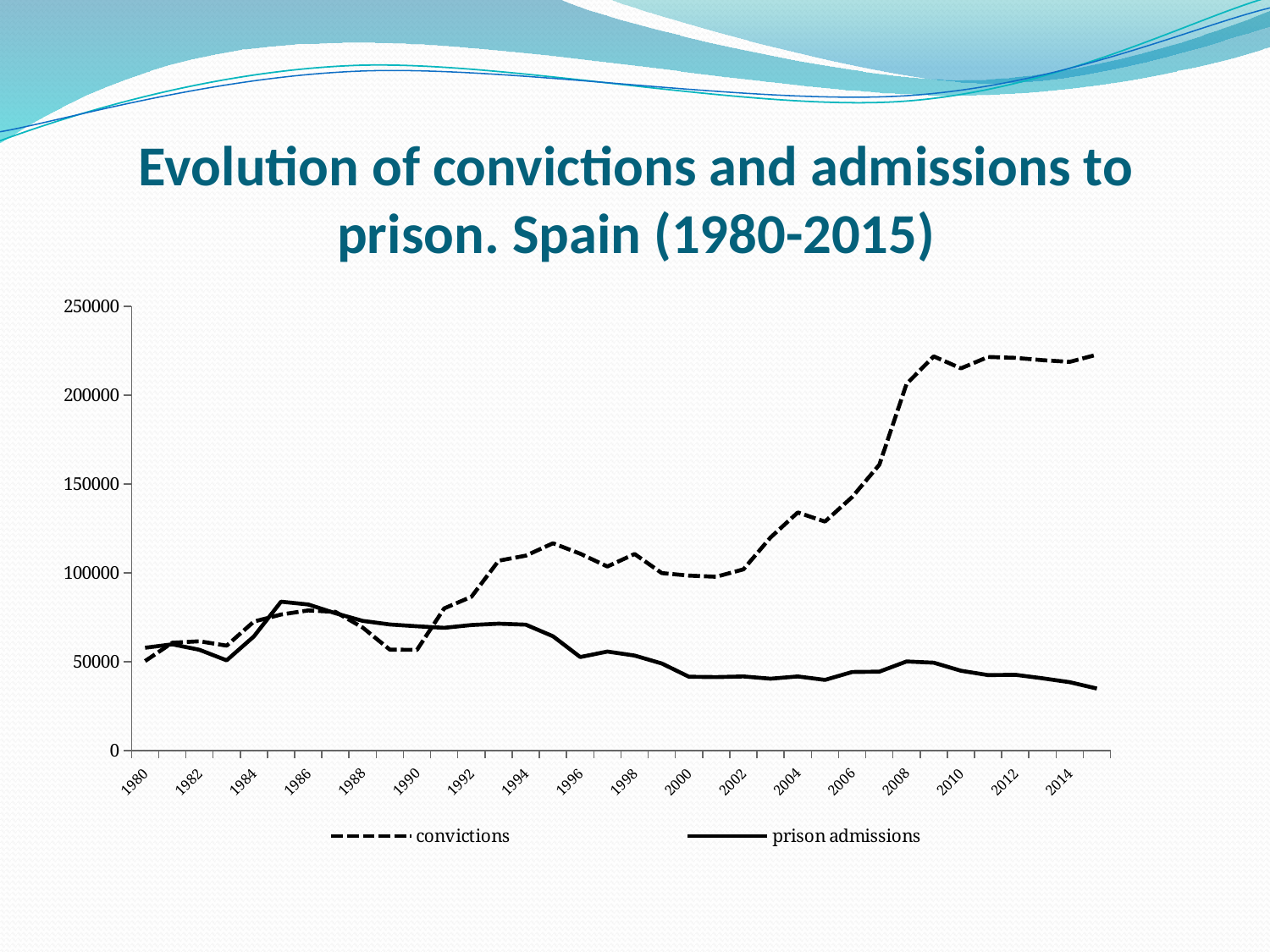
Which series reaches the highest value on the chart? convictions Is the value for convictions in 2014 greater or less than 200000? greater Is the value for convictions in 2004 greater or less than 100000? greater What are the two series named in the legend? convictions and prison admissions How many series does the legend list? 2 Is the value for prison admissions in 2014 greater or less than 50000? less Do convictions generally rise or fall between 2000 and 2010? rise What kind of chart is shown on the slide? line chart Which series is drawn with a dashed line? convictions In 2010, which is larger: convictions or prison admissions? convictions